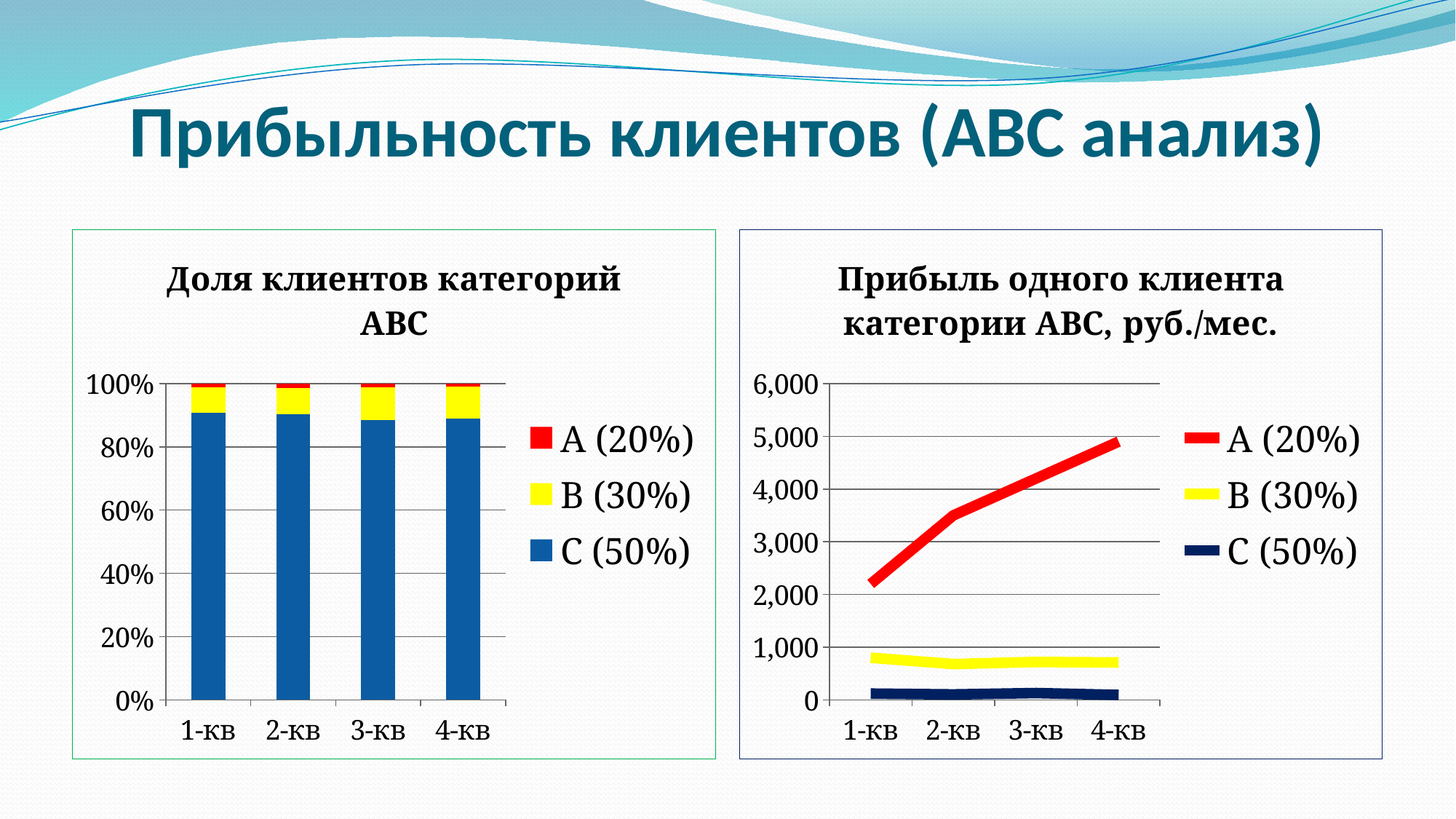
What kind of chart is the right chart, "Прибыль одного клиента категории ABC, руб./мес."? line chart In the left chart "Доля клиентов категорий ABC", which series takes up the largest part of each bar? C (50%) In the right chart "Прибыль одного клиента категории ABC, руб./мес.", which series has the highest values across all quarters? A (20%) In the left chart "Доля клиентов категорий ABC", how many categories are shown on the x axis? 4 In the right chart "Прибыль одного клиента категории ABC, руб./мес.", how many series does the legend list? 3 In the right chart "Прибыль одного клиента категории ABC, руб./мес.", is the value for B (30%) at 1-кв greater or less than 1,000? less What kind of chart is the left chart, "Доля клиентов категорий ABC"? bar chart In the right chart "Прибыль одного клиента категории ABC, руб./мес.", is the value for A (20%) at 4-кв greater or less than 4,000? greater In the right chart "Прибыль одного клиента категории ABC, руб./мес.", is the value for A (20%) at 1-кв greater or less than 3,000? less In the right chart "Прибыль одного клиента категории ABC, руб./мес.", does the value for A (20%) rise or fall from 1-кв to 4-кв? rise In the left chart "Доля клиентов категорий ABC", what colour represents the series B (30%)? yellow In the right chart "Прибыль одного клиента категории ABC, руб./мес.", which is larger at 4-кв: A (20%) or C (50%)? A (20%)